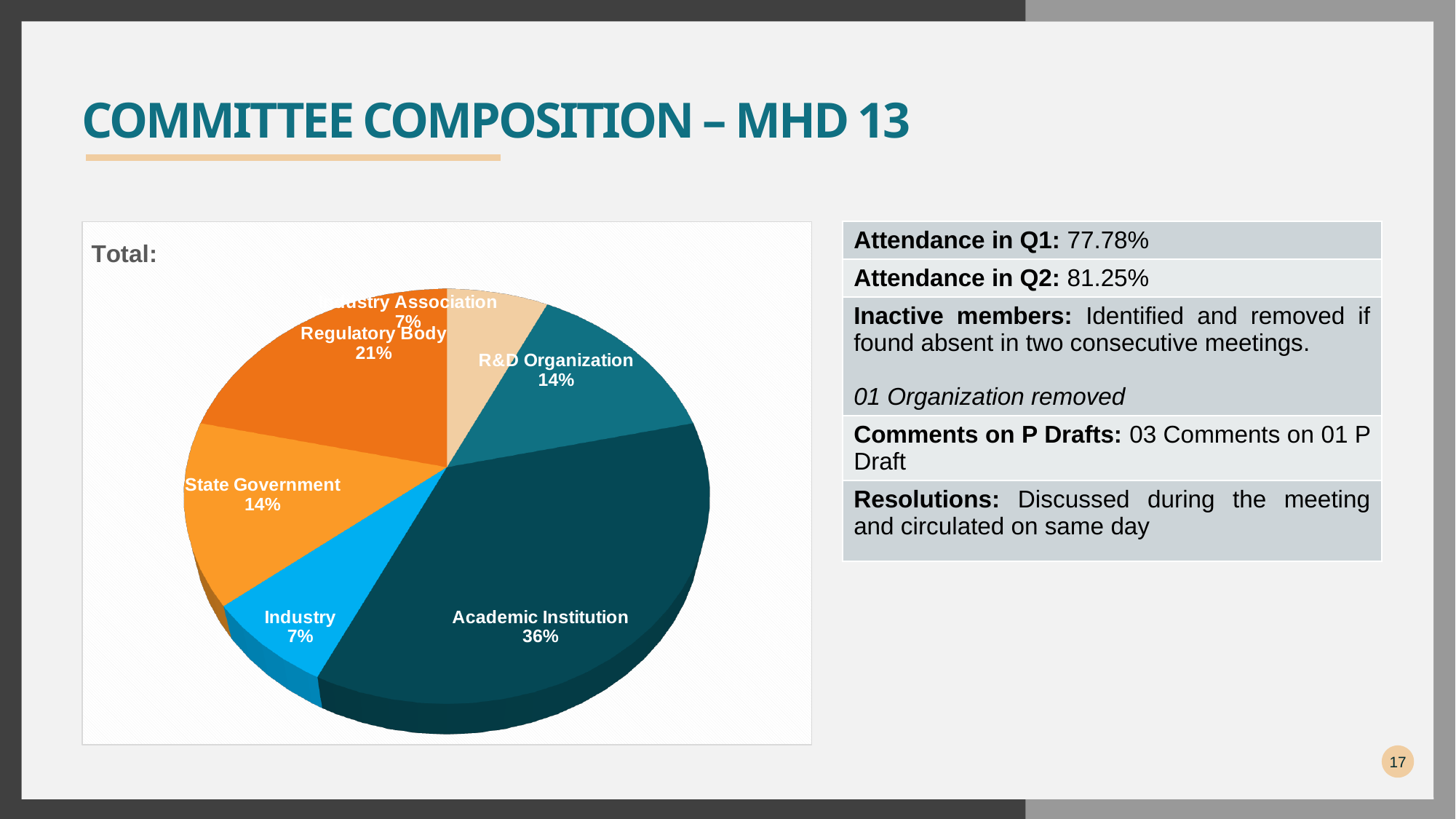
What is the value shown for Industry? 7% Which category has the largest slice of the pie? Academic Institution What is the value shown for R&D Organization? 14% What is the value shown for Industry Association? 7% What is the title of the pie chart? Total: What is the value shown for State Government? 14% What is the value shown for Regulatory Body? 21% How many categories are shown in the pie chart? 6 What is the difference between the Academic Institution share and the Regulatory Body share? 15% Which is larger, the share for Regulatory Body or the share for R&D Organization? Regulatory Body What share of the pie does Academic Institution hold? 36% What kind of chart is shown on the slide? pie chart